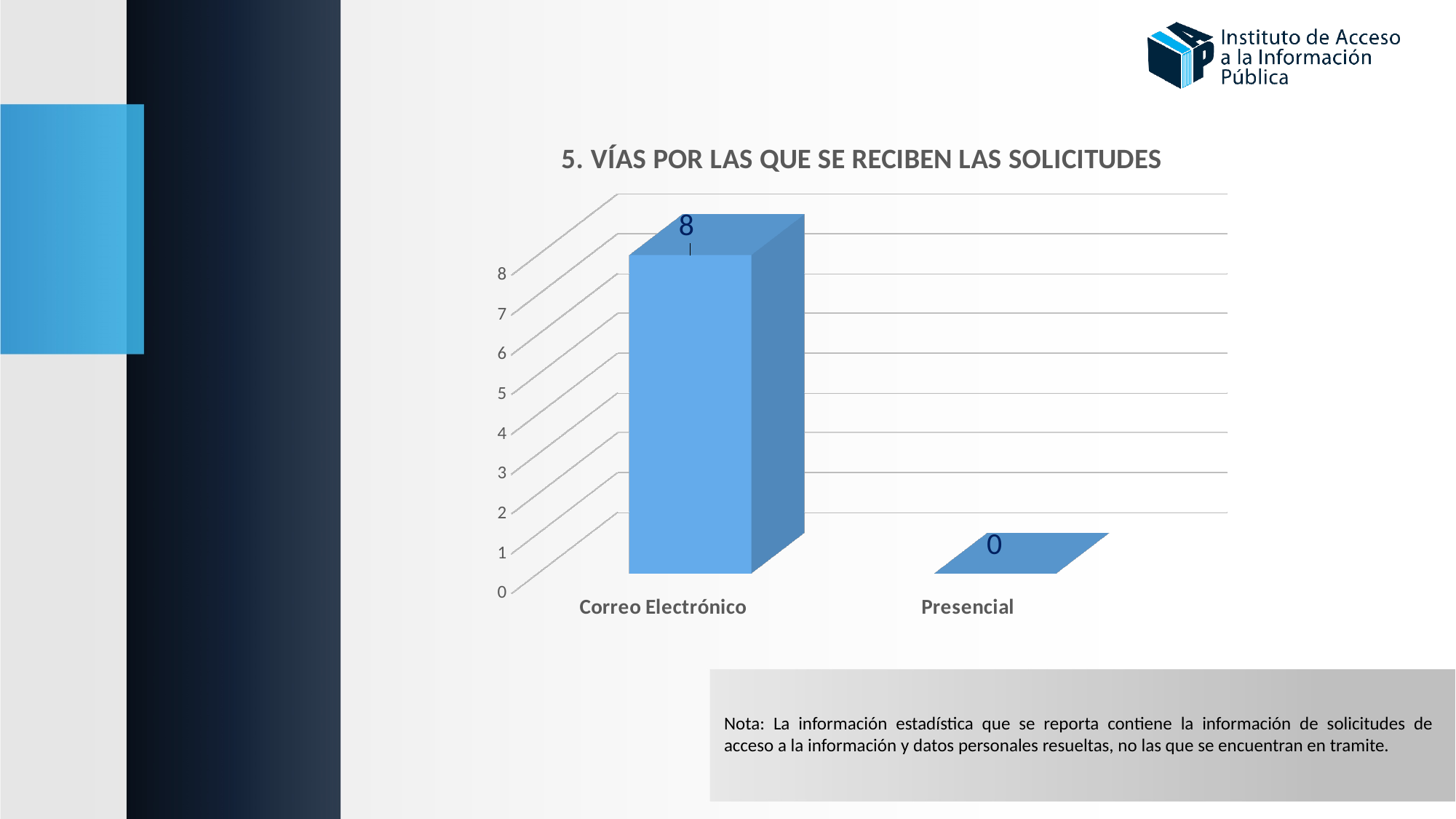
Which is larger, the value for Correo Electrónico or the value for Presencial? Correo Electrónico How many categories are shown on the x axis? 2 What is the highest value shown on the vertical axis? 8 Which category has the lowest value? Presencial What is the title of the chart? 5. VÍAS POR LAS QUE SE RECIBEN LAS SOLICITUDES What kind of chart is shown on the slide? bar chart What is the value for Correo Electrónico? 8 Which category has the highest value? Correo Electrónico What is the value for Presencial? 0 Is the value for Correo Electrónico greater or less than 5? greater What is the difference between the values for Correo Electrónico and Presencial? 8 What is the total of the values for Correo Electrónico and Presencial? 8